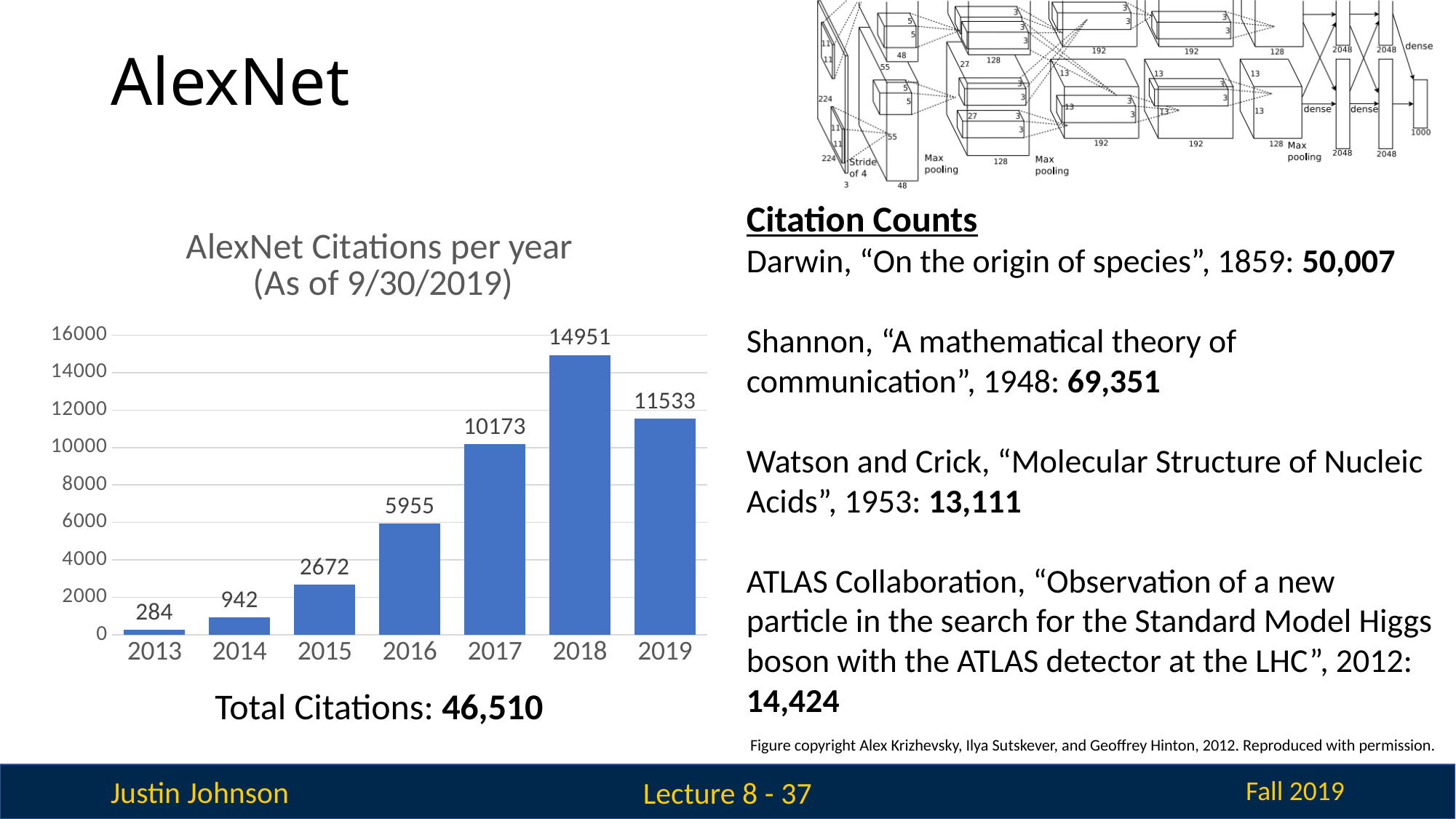
What is the title of the chart? AlexNet Citations per year (As of 9/30/2019) What is the difference in citations between 2018 and 2019? 3418 Is the value for 2017 greater or less than 8000? greater What kind of chart is used to show AlexNet citations per year? bar chart What is the number of AlexNet citations in 2013? 284 How many years are shown on the x axis of the chart? 7 Which year has the highest number of AlexNet citations? 2018 Which year has more citations, 2015 or 2019? 2019 What is the number of AlexNet citations in 2018? 14951 Which year has the lowest number of AlexNet citations? 2013 What is the number of AlexNet citations in 2016? 5955 What is the difference in citations between 2017 and 2016? 4218